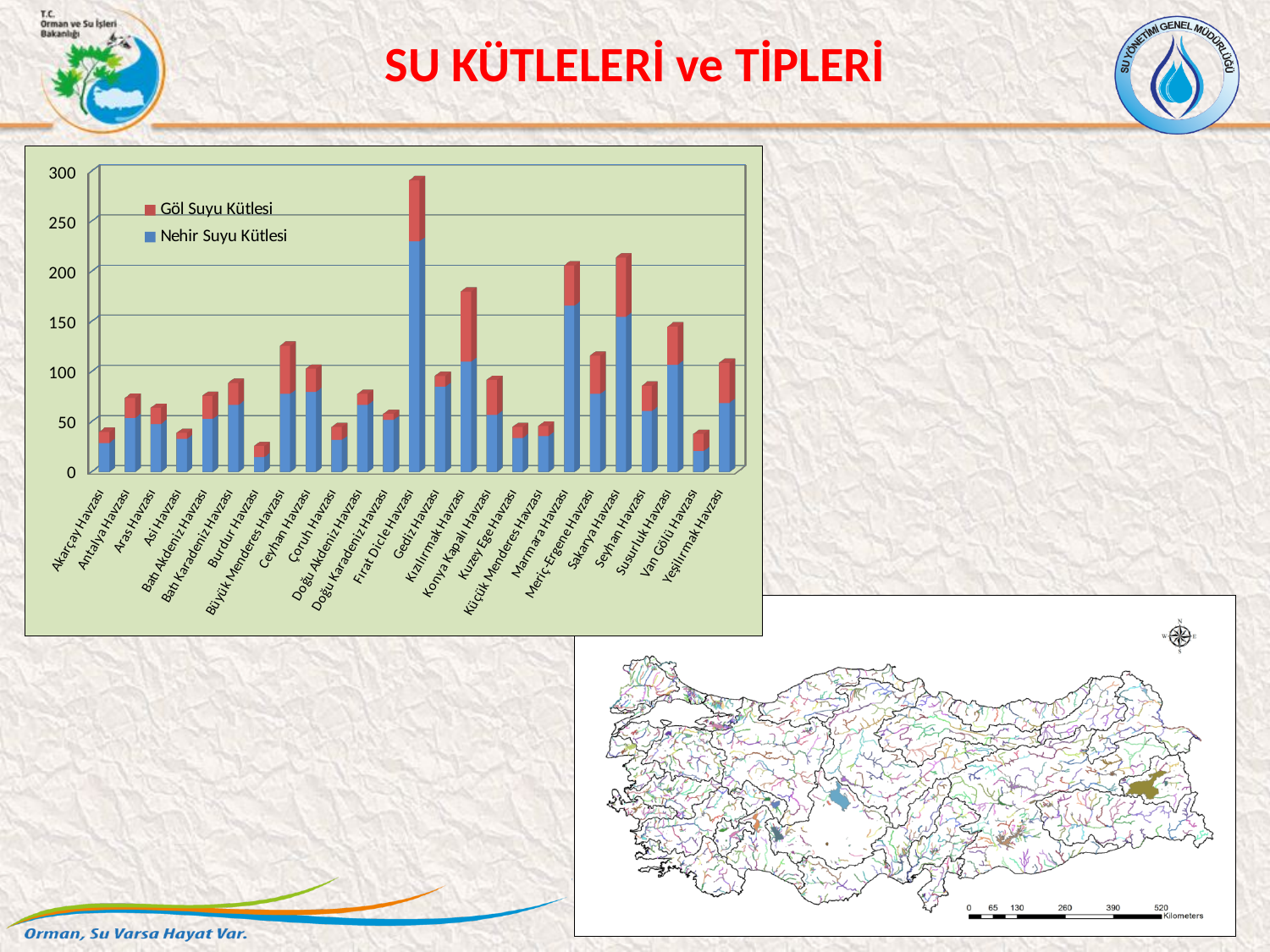
How many series does the chart legend list? 2 Which basin has the lowest total bar in the chart? Burdur Havzası Which has the larger total bar, Susurluk Havzası or Seyhan Havzası? Susurluk Havzası How many basins (categories) are shown on the x axis of the chart? 25 Which has the larger total bar, Fırat Dicle Havzası or Sakarya Havzası? Fırat Dicle Havzası Is the total value for Fırat Dicle Havzası greater or less than 250? greater What kind of chart is shown on the slide? bar chart Is the total value for Burdur Havzası greater or less than 50? less Which colour represents Göl Suyu Kütlesi in the chart legend? red Which basin has the highest total bar in the chart? Fırat Dicle Havzası Is the total value for Kızılırmak Havzası greater or less than 150? greater